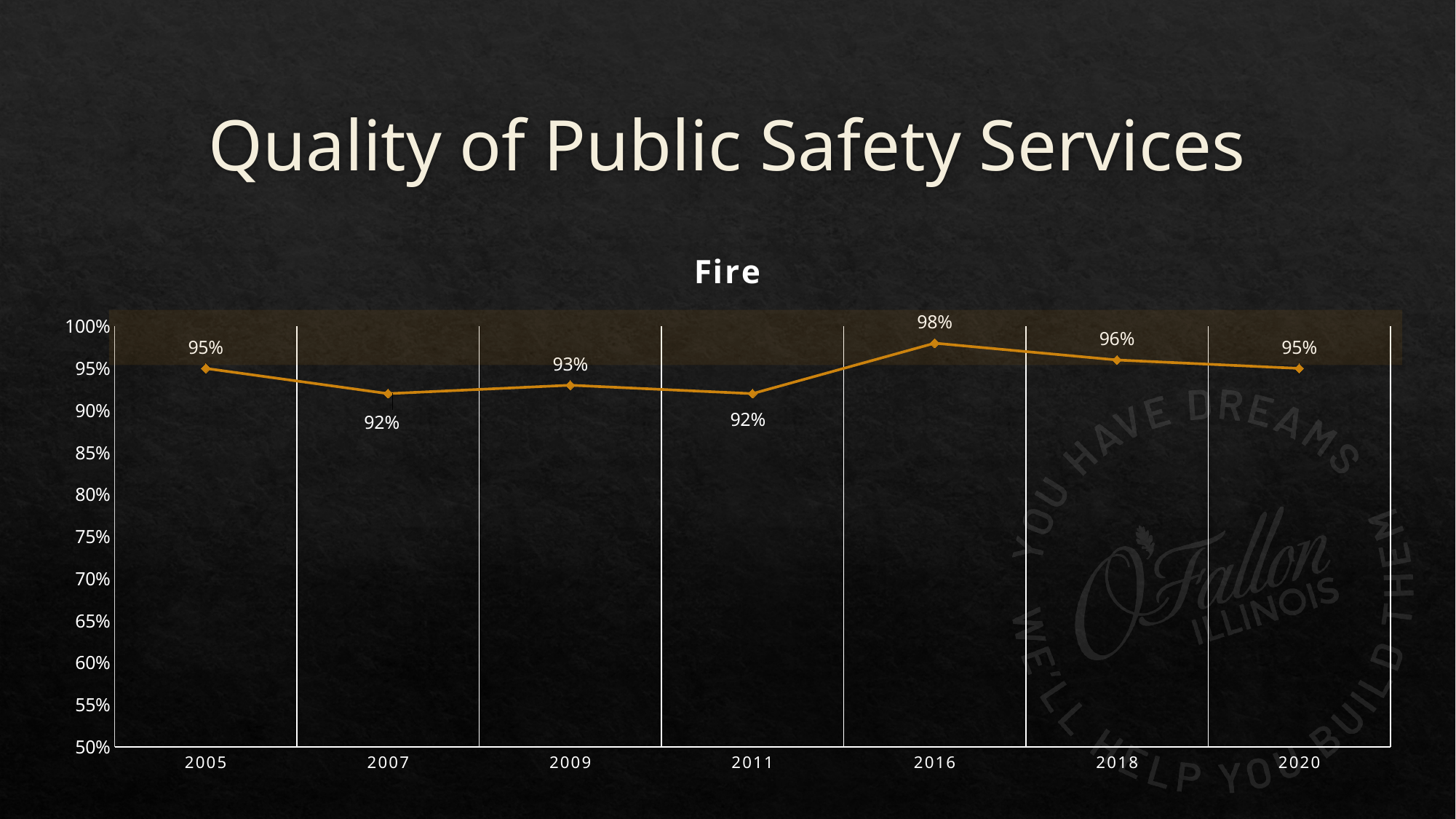
What is the value for 2007? 92% What is the difference between the values for 2016 and 2011? 6% What is the value for 2018? 96% Which is larger, the value for 2018 or the value for 2009? 2018 What is the value for 2016? 98% What is the value for 2009? 93% Is the value for 2011 greater or less than 95%? less What kind of chart is shown? line chart How many years are plotted on the chart? 7 What is the title of the chart? Fire Which year has the highest value? 2016 Does the value rise or fall from 2011 to 2016? rise